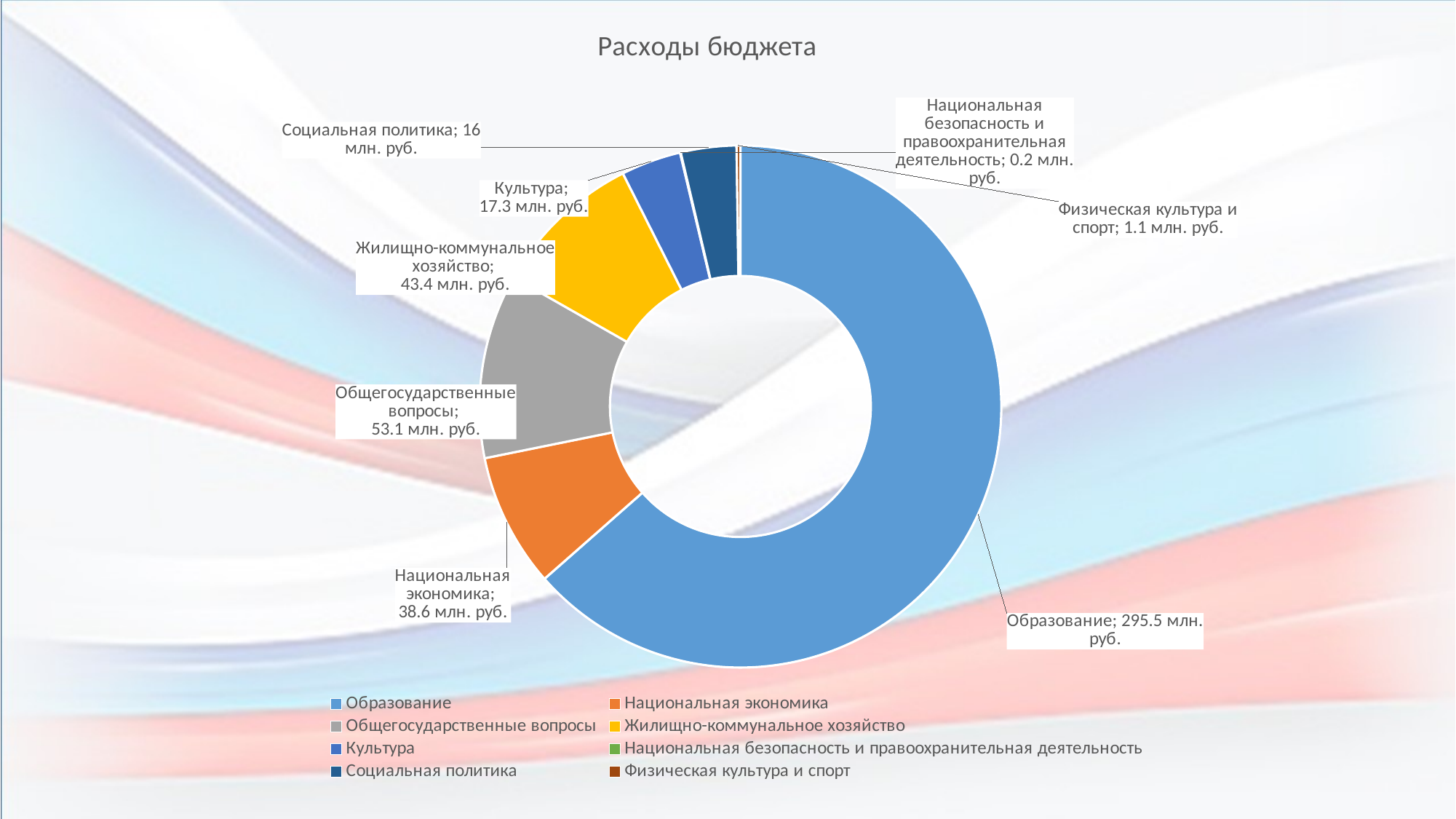
What colour is the Культура segment? Blue What is the title of the chart? Расходы бюджета What is the value for Общегосударственные вопросы? 53.1 млн. руб. What is the difference between the values for Общегосударственные вопросы and Национальная экономика? 14.5 млн. руб. What kind of chart is shown on the slide? Doughnut (ring) chart What is the value for Образование? 295.5 млн. руб. Which category has the smallest value? Национальная безопасность и правоохранительная деятельность Which category has the largest value? Образование What is the value for Национальная безопасность и правоохранительная деятельность? 0.2 млн. руб. How many categories does the chart show? 8 What is the value for Жилищно-коммунальное хозяйство? 43.4 млн. руб. Which is larger, Национальная экономика or Жилищно-коммунальное хозяйство? Жилищно-коммунальное хозяйство